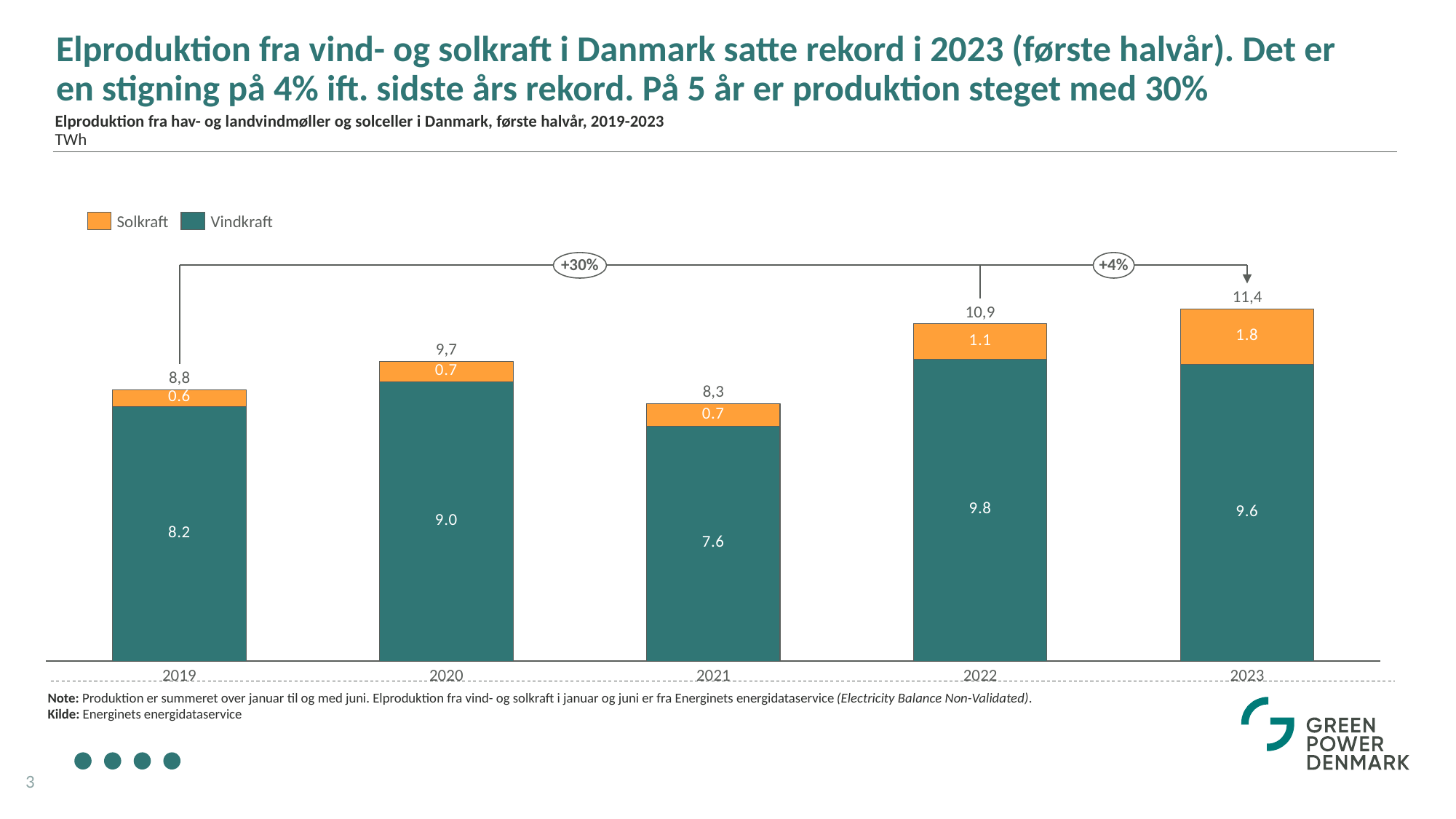
What is the Solkraft value for 2023? 1.8 Which year has the highest total electricity production? 2023 How many series does the legend list? 2 Is the Vindkraft value larger in 2020 or in 2021? 2020 What percentage increase is shown in the callout between 2022 and 2023? +4% Which year has the lowest total electricity production? 2021 What is the difference between the Solkraft values for 2023 and 2022? 0.7 How many years are shown on the x axis? 5 Which year has the highest Vindkraft value? 2022 What is the total labelled above the 2021 bar? 8,3 What kind of chart is shown on the slide? Stacked bar chart What is the Vindkraft value for 2022? 9.8